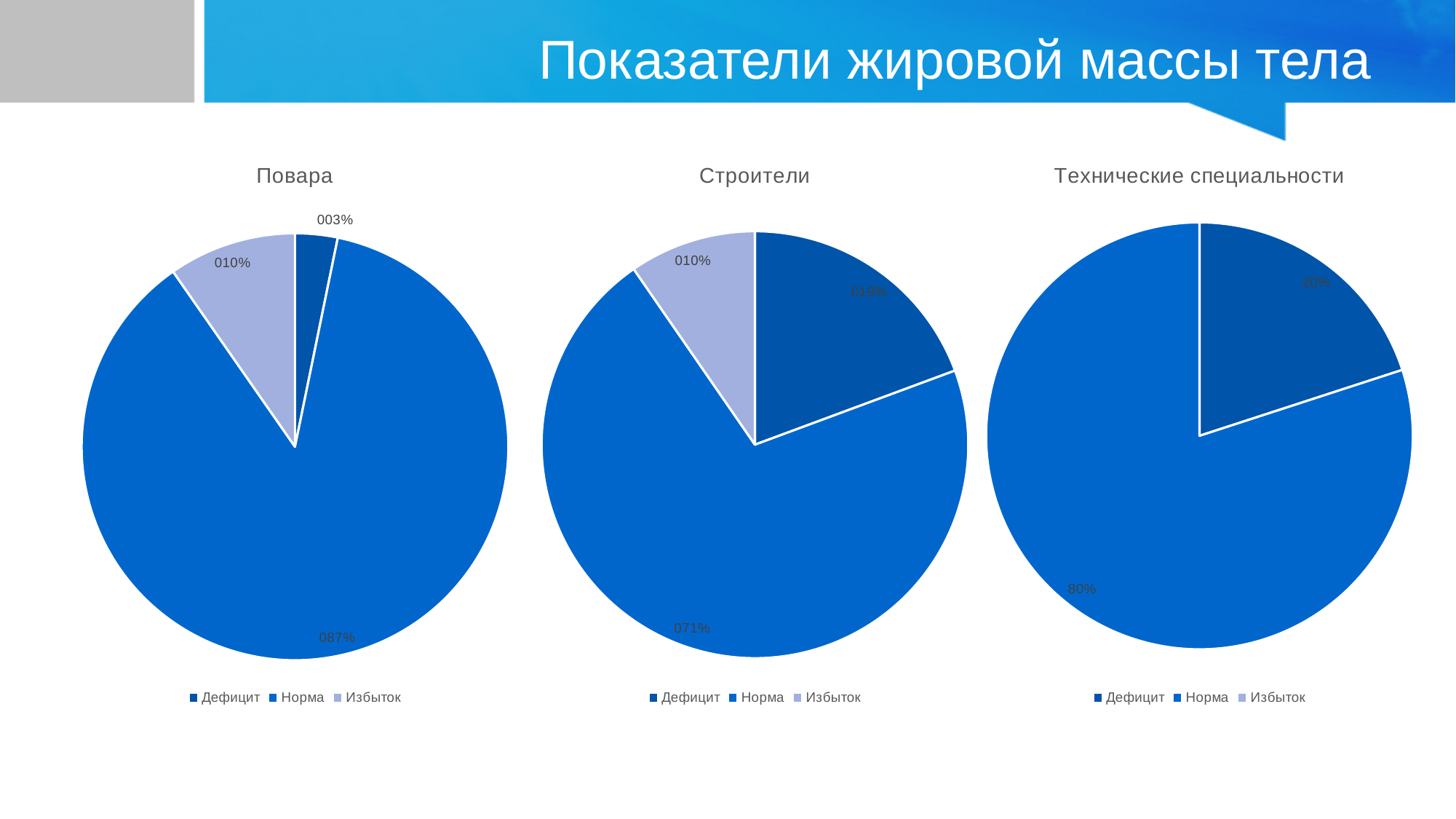
What type of chart is used for "Строители"? Pie chart In the "Технические специальности" pie chart, what is the value shown for Норма? 80% In the "Повара" pie chart, which category has the largest slice? Норма In the "Строители" pie chart, what is the value shown for Дефицит? 019% How many entries does the legend of the "Повара" chart list? 3 In the "Повара" pie chart, which category has the smallest slice? Дефицит What is the title of the chart on the right of the slide? Технические специальности In the "Строители" pie chart, what is the value shown for Избыток? 010% In the "Строители" pie chart, which is larger, Дефицит or Избыток? Дефицит In the "Повара" pie chart, what is the value shown for Дефицит? 003% In the "Технические специальности" pie chart, what is the value shown for Дефицит? 20% In the "Повара" pie chart, what is the value shown for Норма? 087%